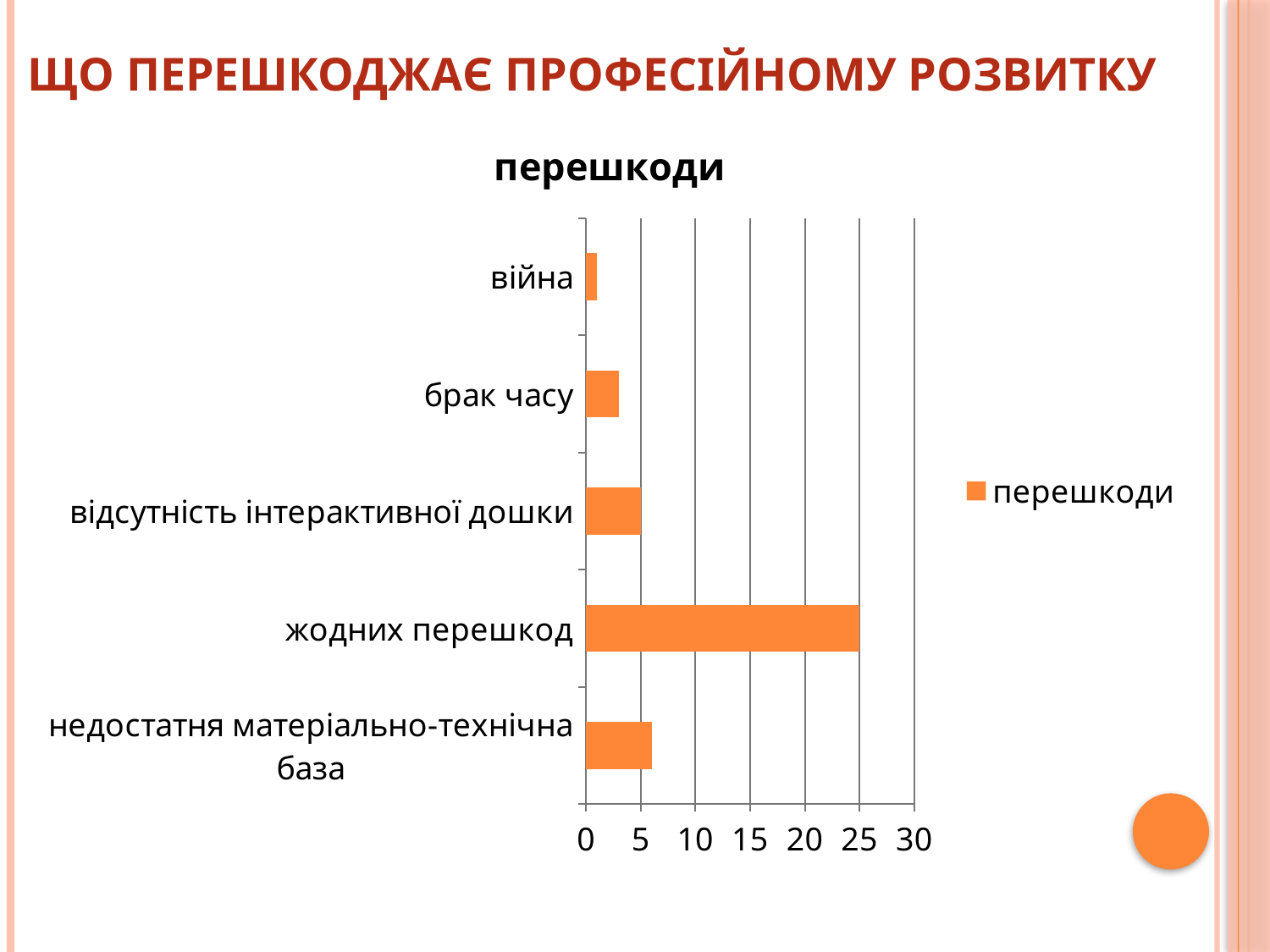
What is the title of the chart? перешкоди What kind of chart is shown on the slide? bar chart Which is larger, the value for брак часу or the value for війна? брак часу Is the value for недостатня матеріально-технічна база greater or less than 10? less What is the difference between the values for жодних перешкод and відсутність інтерактивної дошки? 20 How many categories are shown in the chart? 5 How many series does the legend list? 1 What is the value for відсутність інтерактивної дошки? 5 Which category has the lowest value? війна Is the value for брак часу greater or less than 5? less What is the value for жодних перешкод? 25 Which category has the highest value? жодних перешкод